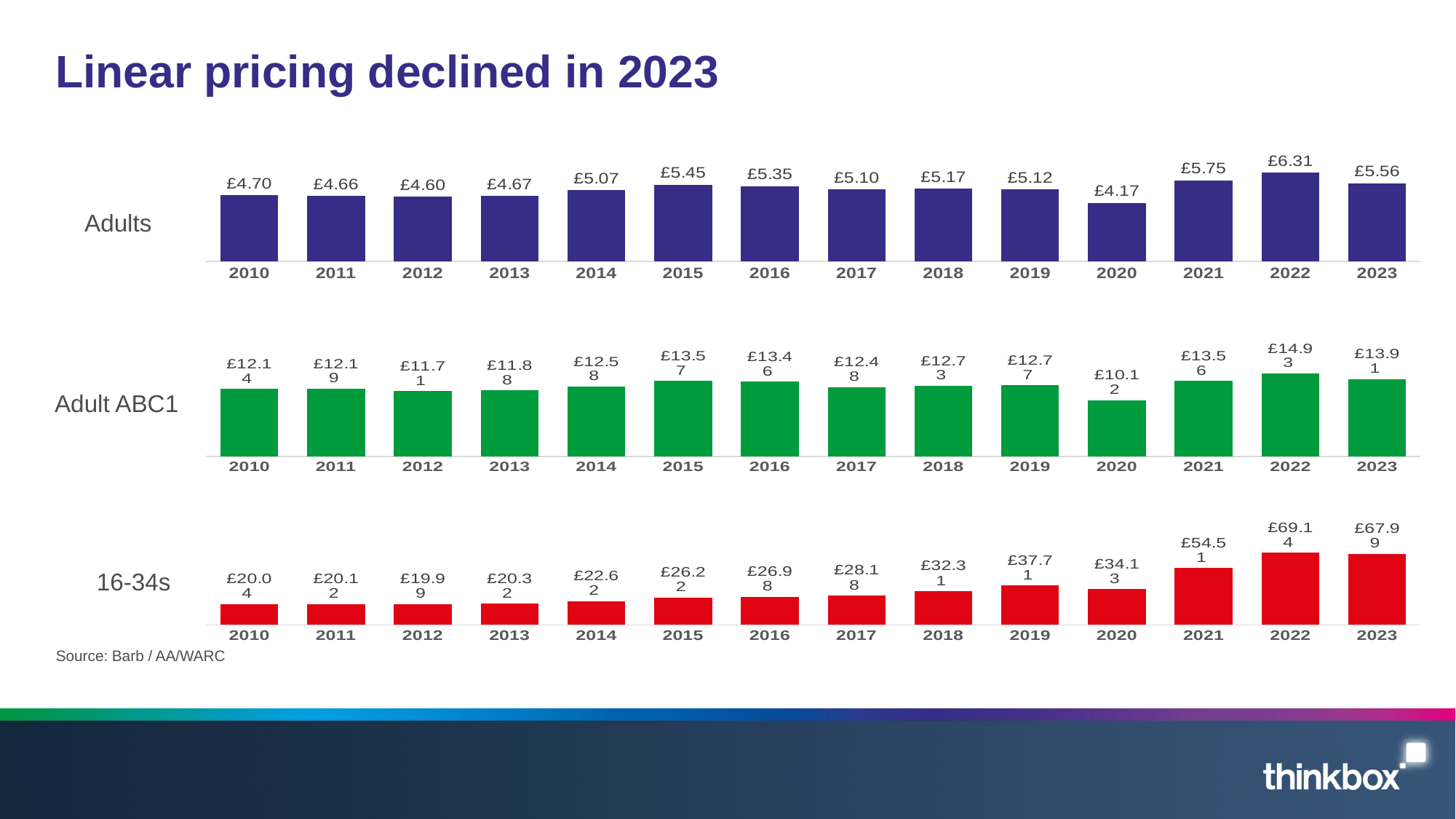
In the Adults chart, what is the value for 2023? £5.56 What kind of chart is the Adults chart? Bar chart How many years are shown on the x axis of the Adults chart? 14 In the Adult ABC1 chart, which year has the highest value? 2022 In the Adult ABC1 chart, what is the value for 2020? £10.12 In the 16-34s chart, which is larger, the value for 2020 or the value for 2021? 2021 In the 16-34s chart, do the values generally rise or fall from 2010 to 2023? Rise In the 16-34s chart, which year has the lowest value? 2012 In the Adults chart, what is the difference between the 2022 value and the 2023 value? £0.75 In the Adults chart, which year has the highest value? 2022 In the Adults chart, which year has the lowest value? 2020 In the 16-34s chart, what is the value for 2022? £69.14